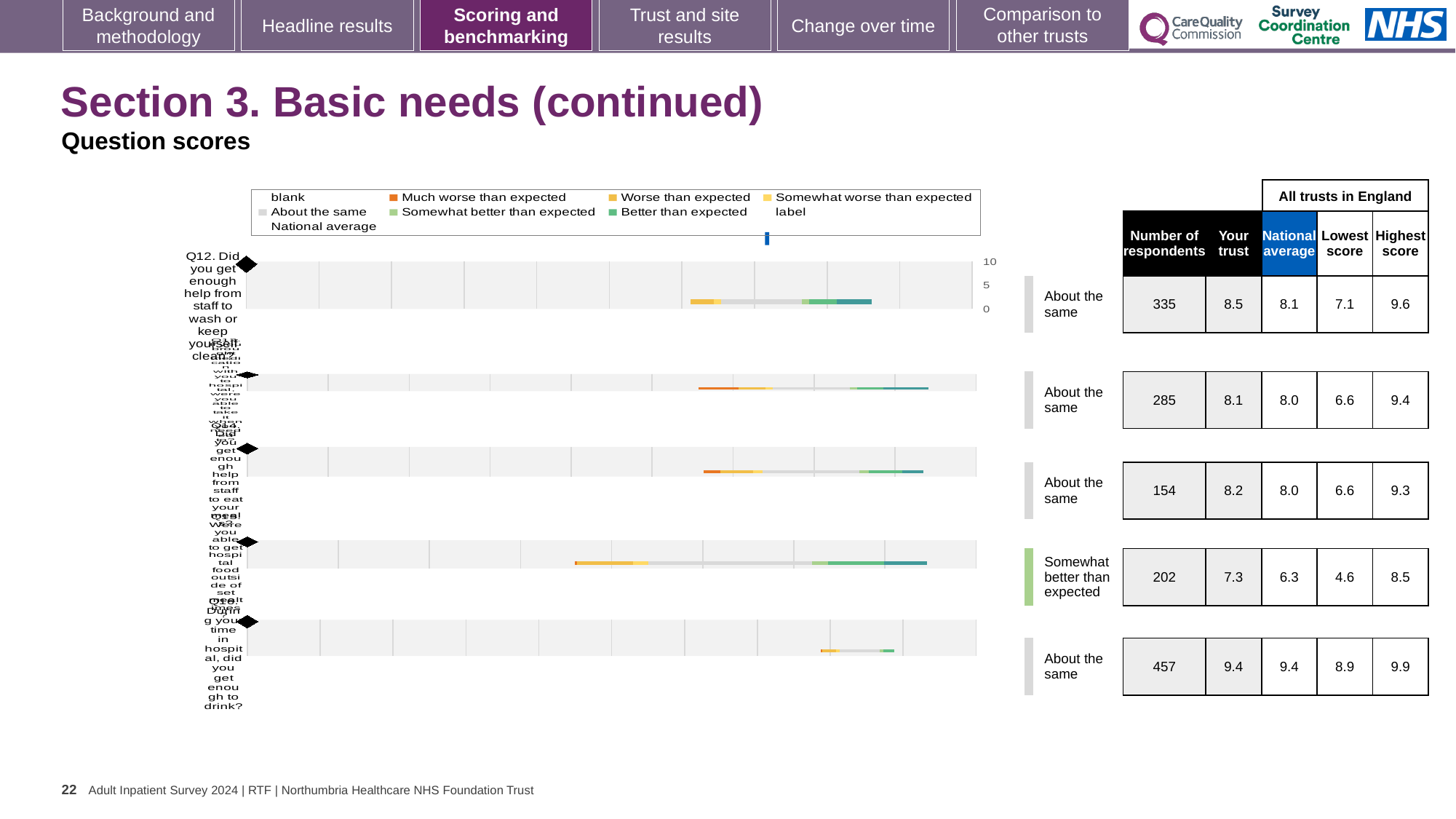
What is the lowest score among all trusts in England for Q14 (help from staff to eat your meals)? 6.6 What is the difference between the 'Your trust' score and the national average for Q15? 1.0 How many respondents answered Q16 (did you get enough to drink)? 457 Which question is rated 'Somewhat better than expected'? Q15 What is the highest score among all trusts in England for Q15 (hospital food outside of set meal times)? 8.5 What is the 'Your trust' score for Q12 (help from staff to wash or keep yourself clean)? 8.5 What kind of chart is used to show the question scores on this slide? bar chart Which question has the highest 'Your trust' score? Q16 How many question rows are plotted in the chart? 5 What is the national average score for Q12? 8.1 For Q12, which is larger: the 'Your trust' score or the national average? Your trust Which question has the lowest 'Your trust' score? Q15